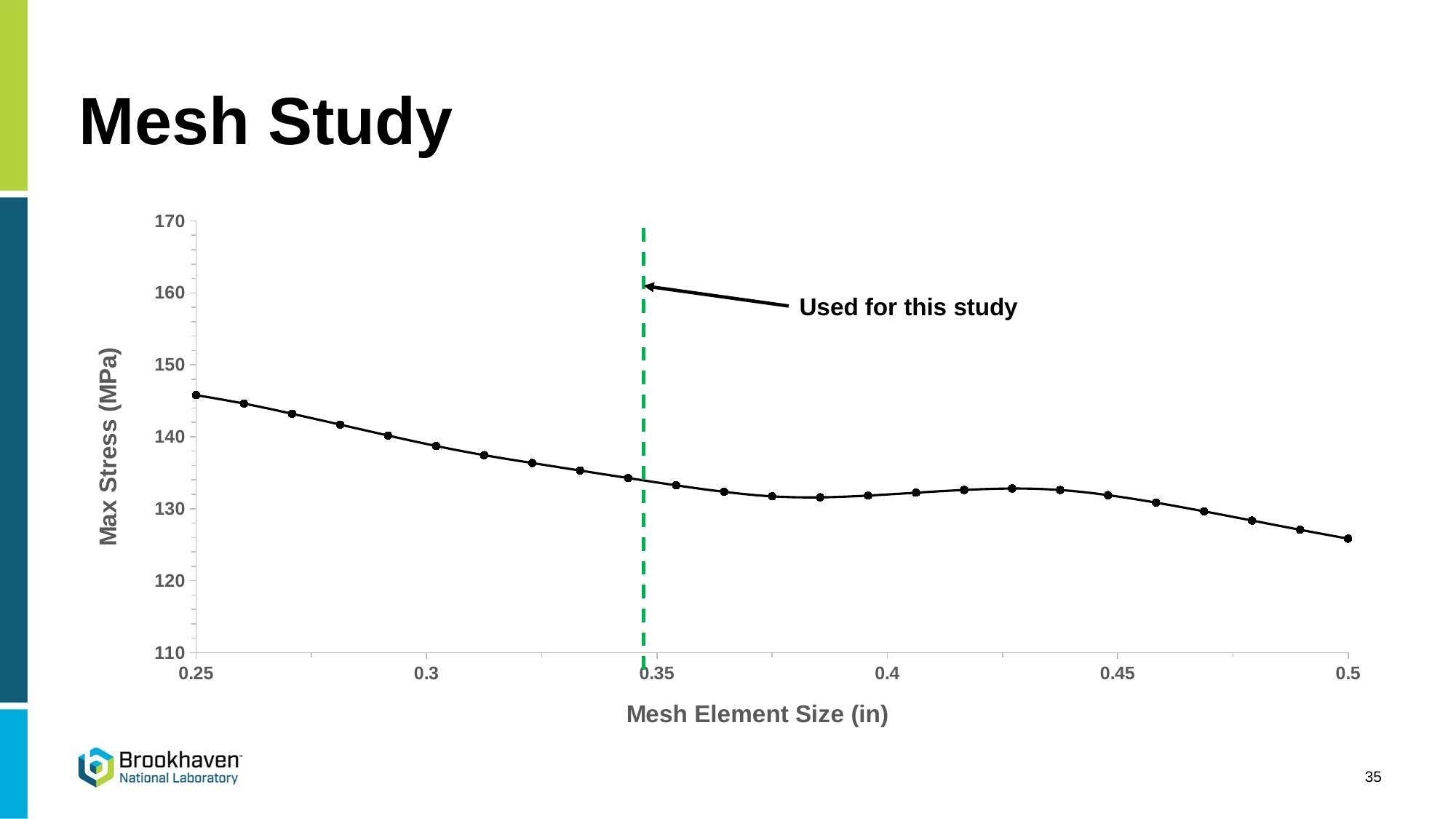
What is the title of the chart's y axis? Max Stress (MPa) Is the max stress at a mesh element size of 0.25 in greater or less than 140 MPa? greater Is the max stress at a mesh element size of 0.5 in greater or less than 130 MPa? less Is the max stress at a mesh element size of 0.35 in greater or less than 140 MPa? less At which mesh element size is the max stress highest? 0.25 How many data points are plotted on the line? 25 What kind of chart is shown on the slide? line chart Overall, does the max stress rise or fall as the mesh element size increases from 0.25 to 0.5 in? fall Which has the larger max stress: a mesh element size of 0.3 in or 0.4 in? 0.3 What is the title of the chart's x axis? Mesh Element Size (in) At which mesh element size is the max stress lowest? 0.5